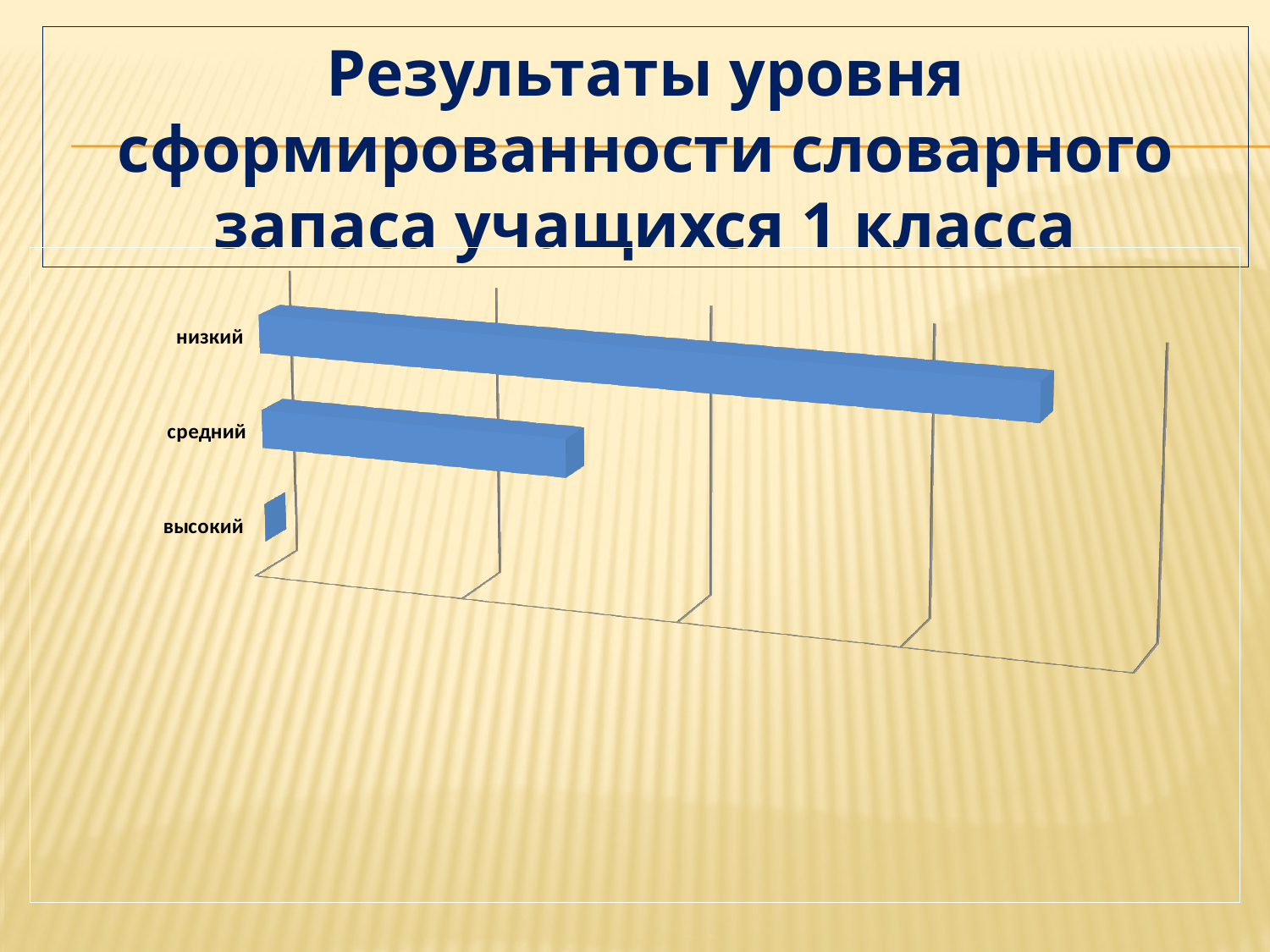
What colour are the bars in the chart? blue Which is smaller, the value for низкий or the value for высокий? высокий Which is larger, the value for средний or the value for высокий? средний How many categories are plotted in the chart? 3 Are the bars in the chart drawn horizontally or vertically? horizontally Which category has the highest value in the chart? низкий Which is larger, the value for низкий or the value for средний? низкий Which category is listed at the top of the chart? низкий Which category has the lowest value in the chart? высокий What kind of chart is shown on the slide? bar chart